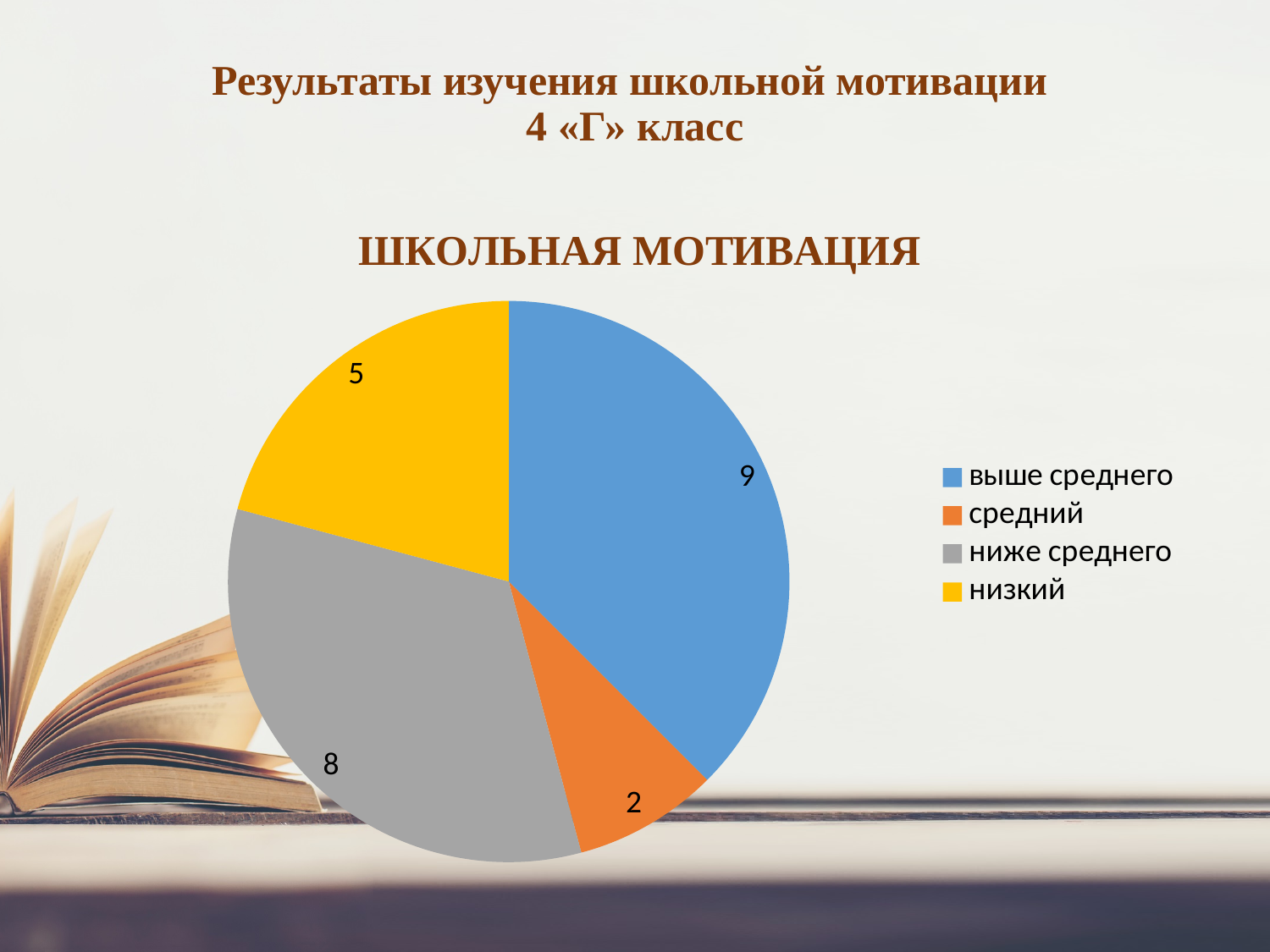
What is the value for "средний"? 2 Which category has the smallest slice? средний What is the value for "низкий"? 5 What is the value for "ниже среднего"? 8 Which category has the largest slice? выше среднего What is the difference between the values for "выше среднего" and "низкий"? 4 How many slices does the pie chart have? 4 What share of the pie does "выше среднего" represent? 37.5% How many entries does the legend list? 4 What kind of chart is shown on the slide? pie chart What is the value for "выше среднего"? 9 What is the title of the chart? ШКОЛЬНАЯ МОТИВАЦИЯ